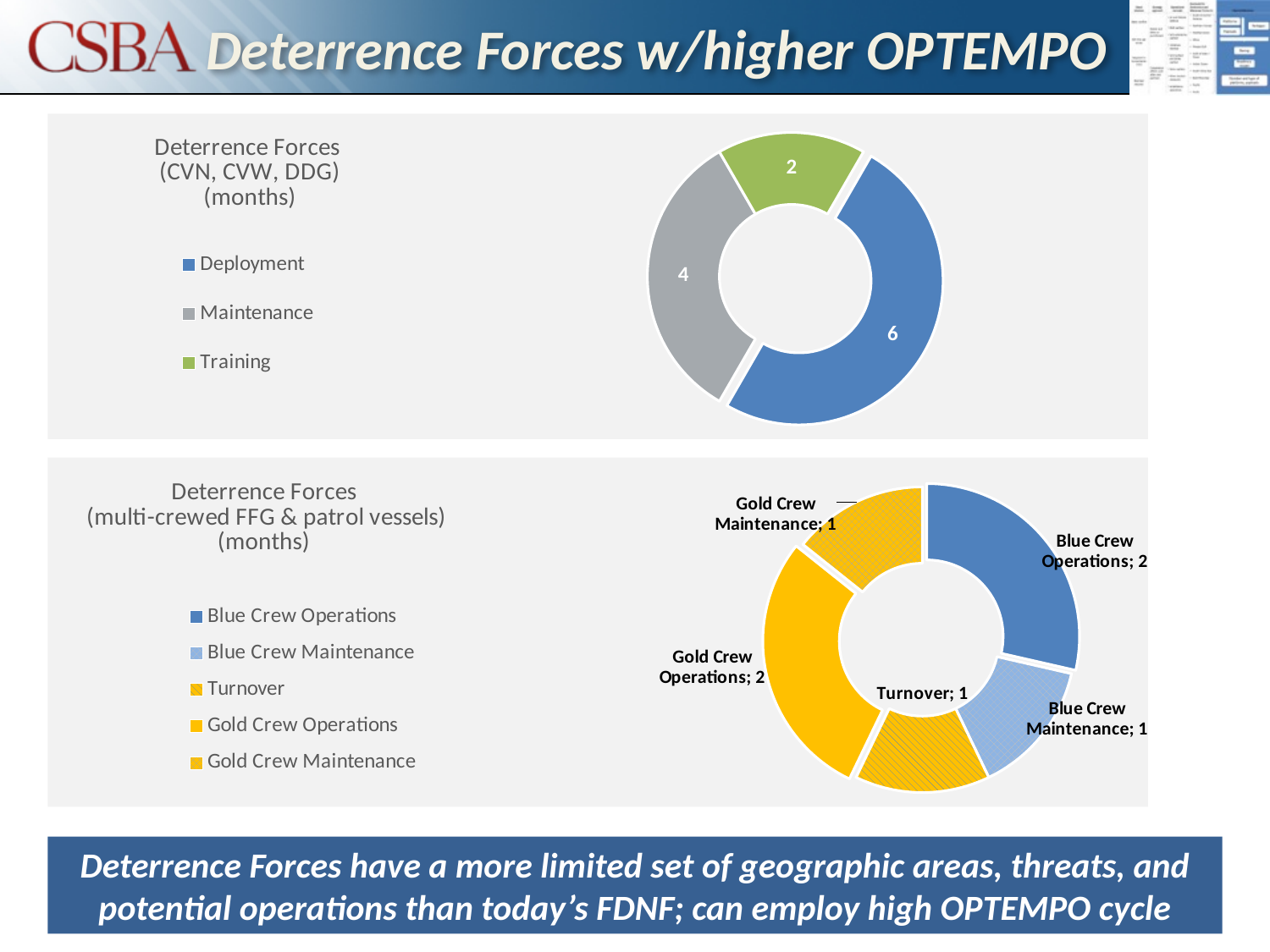
In the top chart (Deterrence Forces CVN, CVW, DDG), which category has the largest value? Deployment In the top chart (Deterrence Forces CVN, CVW, DDG), how many categories does the legend list? 3 In the top chart (Deterrence Forces CVN, CVW, DDG), what is the difference between Deployment and Training? 4 In the bottom chart (multi-crewed FFG & patrol vessels), how many categories does the legend list? 5 In the bottom chart (multi-crewed FFG & patrol vessels), which is larger, Blue Crew Operations or Blue Crew Maintenance? Blue Crew Operations What type of chart is used for the bottom chart (multi-crewed FFG & patrol vessels)? Donut chart In the top chart (Deterrence Forces CVN, CVW, DDG), how many months are shown for Deployment? 6 In the top chart (Deterrence Forces CVN, CVW, DDG), how many months are shown for Maintenance? 4 In the bottom chart (multi-crewed FFG & patrol vessels), how many months are shown for Gold Crew Operations? 2 In the top chart (Deterrence Forces CVN, CVW, DDG), which category has the smallest value? Training In the top chart (Deterrence Forces CVN, CVW, DDG), what share of the total does Deployment represent? 50% In the bottom chart (multi-crewed FFG & patrol vessels), how many months are shown for Turnover? 1